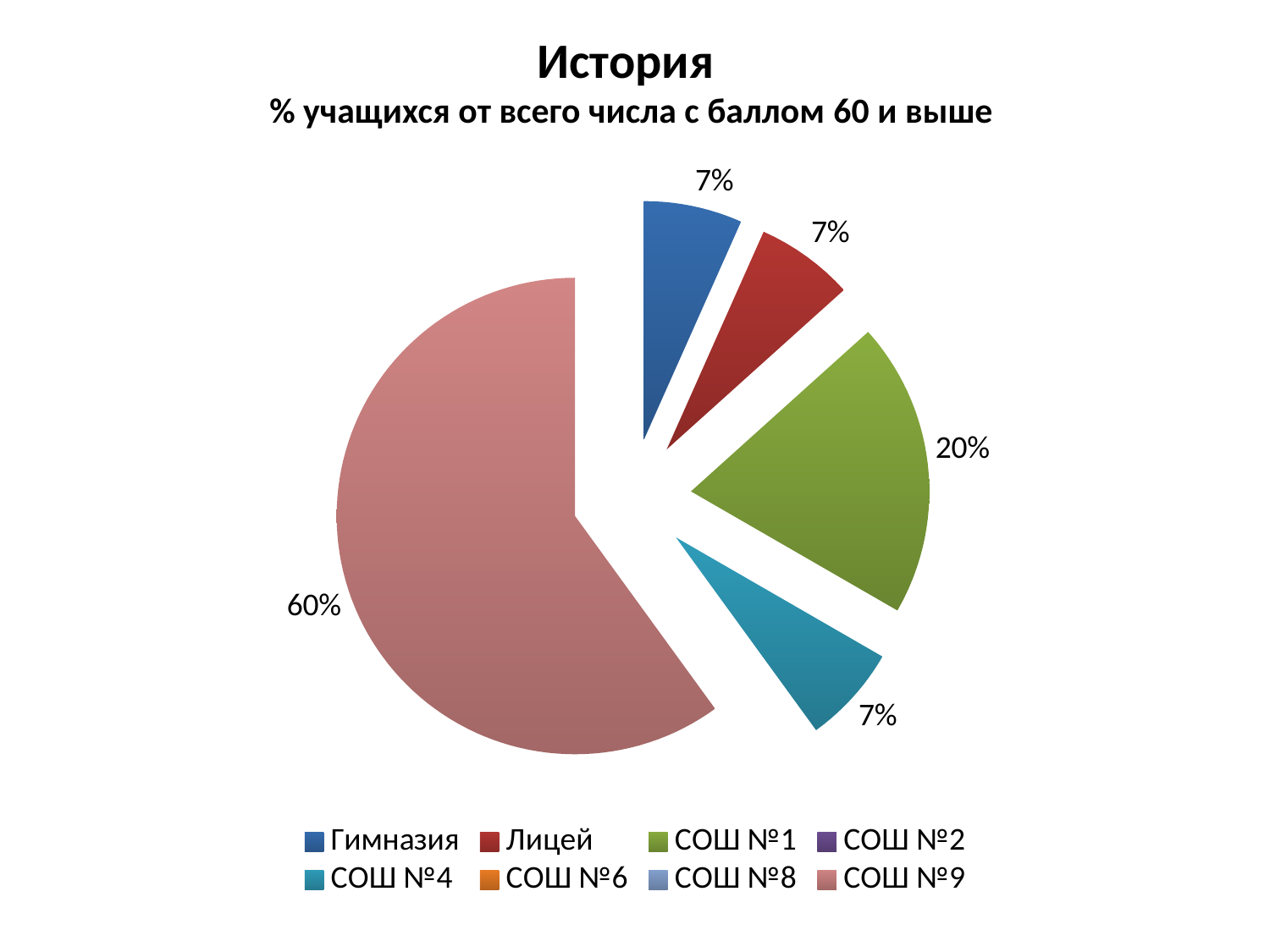
What percentage does the slice for Гимназия represent? 7% How many entries does the legend list? 8 What percentage does the slice for Лицей represent? 7% What is the difference in percentage points between the slices for СОШ №9 and СОШ №1? 40 What percentage does the slice for СОШ №9 represent? 60% Which category has the largest slice of the pie? СОШ №9 What percentage does the slice for СОШ №1 represent? 20% What kind of chart is shown on the slide? Pie chart How many slices with data labels are shown in the pie chart? 5 Which slice is larger, СОШ №1 or Гимназия? СОШ №1 What percentage does the slice for СОШ №4 represent? 7% What is the title of the chart? История